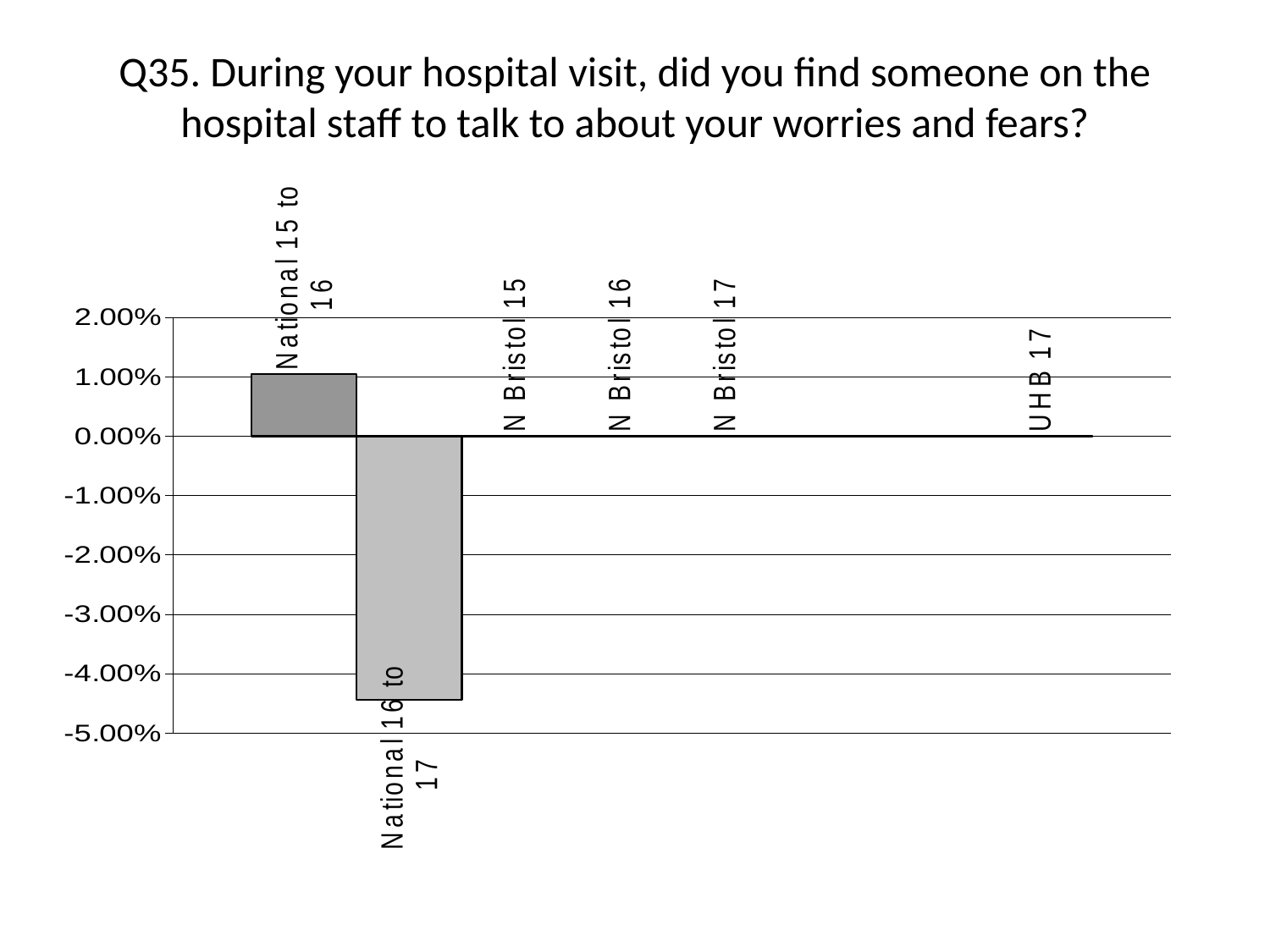
What is the title of the chart? Q35. During your hospital visit, did you find someone on the hospital staff to talk to about your worries and fears? Which category has the lowest value in the chart? National 16 to 17 What kind of chart is shown on the slide? bar chart Does the value rise or fall from National 15 to 16 to National 16 to 17? fall Is the value for National 15 to 16 greater or less than 2.00%? less Is the value for National 16 to 17 greater or less than -4.00%? less Is the value for National 15 to 16 greater or less than 0.00%? greater Which category has the highest value in the chart? National 15 to 16 Which is larger, the value for National 15 to 16 or the value for National 16 to 17? National 15 to 16 How many categories in the chart have a visible bar? 2